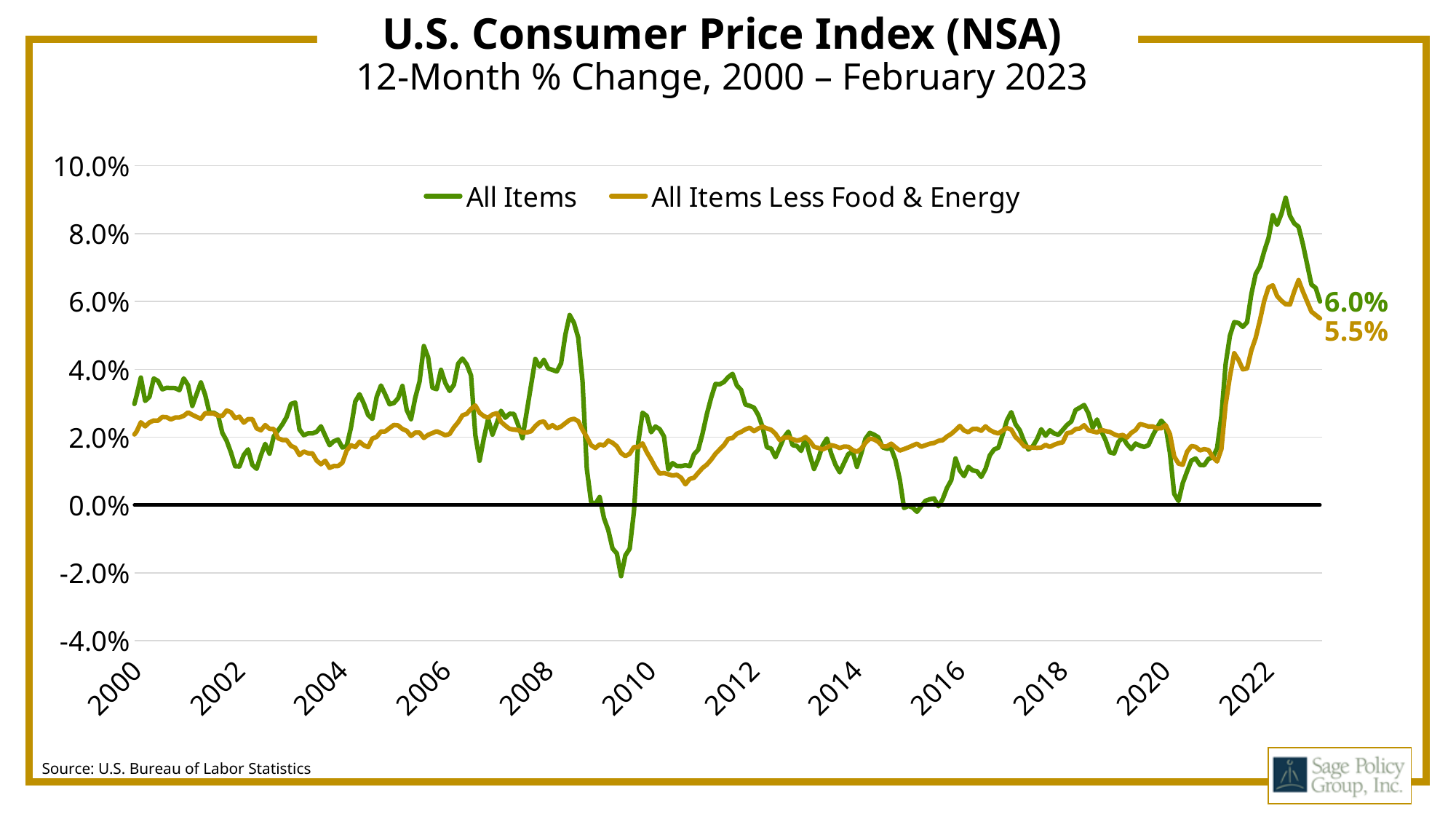
From its 2022 peak to February 2023, does the All Items line rise or fall? fall Is the peak value of the All Items Less Food & Energy series in 2022 greater or less than 6.0%? greater What kind of chart is shown on the slide? Line chart Is the peak value of the All Items series in 2022 greater or less than 8.0%? greater Which series reaches the higher peak in 2022? All Items At the end of the series, which is higher: All Items or All Items Less Food & Energy? All Items Is the lowest value of the All Items series around 2009 greater or less than 0.0%? less How many series does the legend list? 2 What is the difference between the labelled end values of All Items (6.0%) and All Items Less Food & Energy (5.5%)? 0.5% What is the source cited for the chart data? U.S. Bureau of Labor Statistics What is the latest labelled value for the All Items series? 6.0% What is the latest labelled value for the All Items Less Food & Energy series? 5.5%